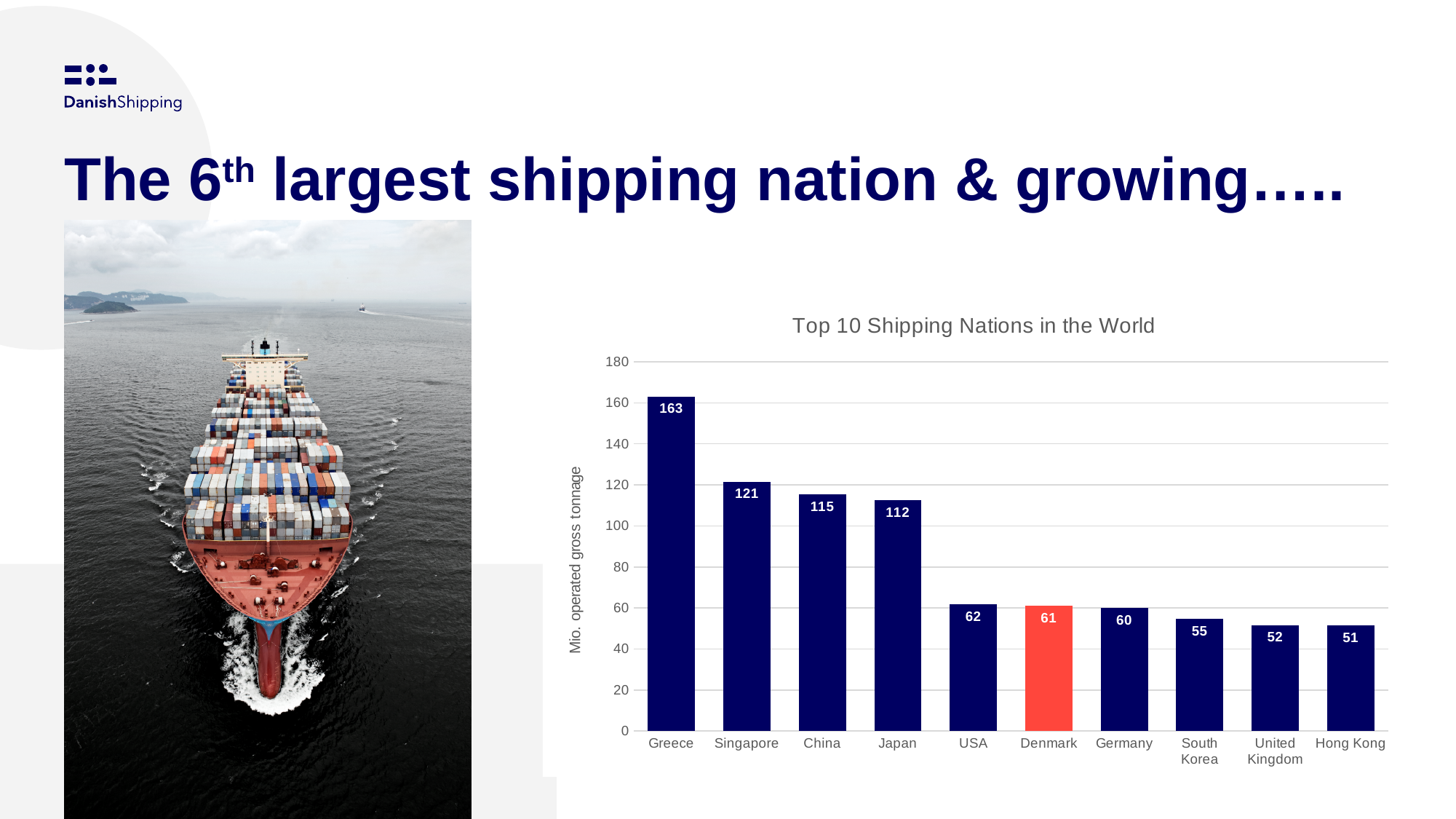
Which country has the highest value? Greece Is the value for Singapore greater or less than 100? greater What is the value for Japan? 112 What is the value for Greece? 163 Which country's bar is coloured red instead of dark blue? Denmark What is the title of the chart? Top 10 Shipping Nations in the World Which has a larger value, China or Japan? China What kind of chart is shown on the slide? bar chart Which country has the lowest value? Hong Kong What is the difference between the values for Greece and Singapore? 42 What is the value for Denmark? 61 How many countries are shown in the chart? 10